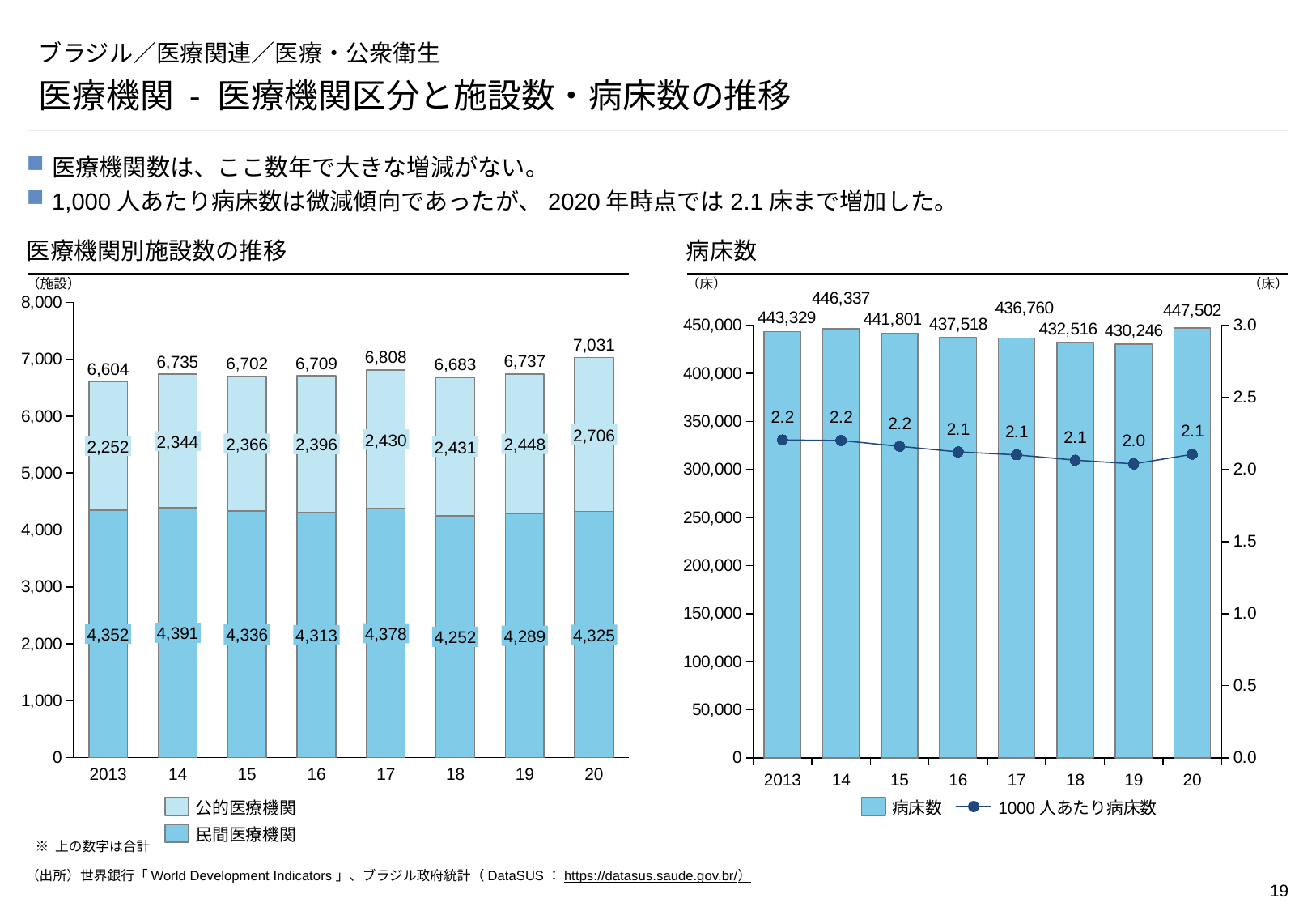
In the 医療機関別施設数の推移 chart on the left, what is the difference between the 公的医療機関 values for 20 and 19? 258 In the 医療機関別施設数の推移 chart on the left, which year has the highest total number of facilities? 20 In the 医療機関別施設数の推移 chart on the left, what is the value for 公的医療機関 in 20? 2,706 In the 医療機関別施設数の推移 chart on the left, which year has the lowest value for 民間医療機関? 18 In the 病床数 chart on the right, which year has the lowest 1000人あたり病床数? 19 In the 病床数 chart on the right, which year has the highest 病床数? 20 In the 病床数 chart on the right, how many years are plotted on the x axis? 8 In the 病床数 chart on the right, what is the 病床数 value for 19? 430,246 In the 医療機関別施設数の推移 chart on the left, what is the total of the stacked bar for 2013? 6,604 In the 医療機関別施設数の推移 chart on the left, what is the value for 民間医療機関 in 17? 4,378 In the 病床数 chart on the right, which is larger, the 病床数 for 14 or for 15? 14 In the 医療機関別施設数の推移 chart on the left, how many series does the legend list? 2